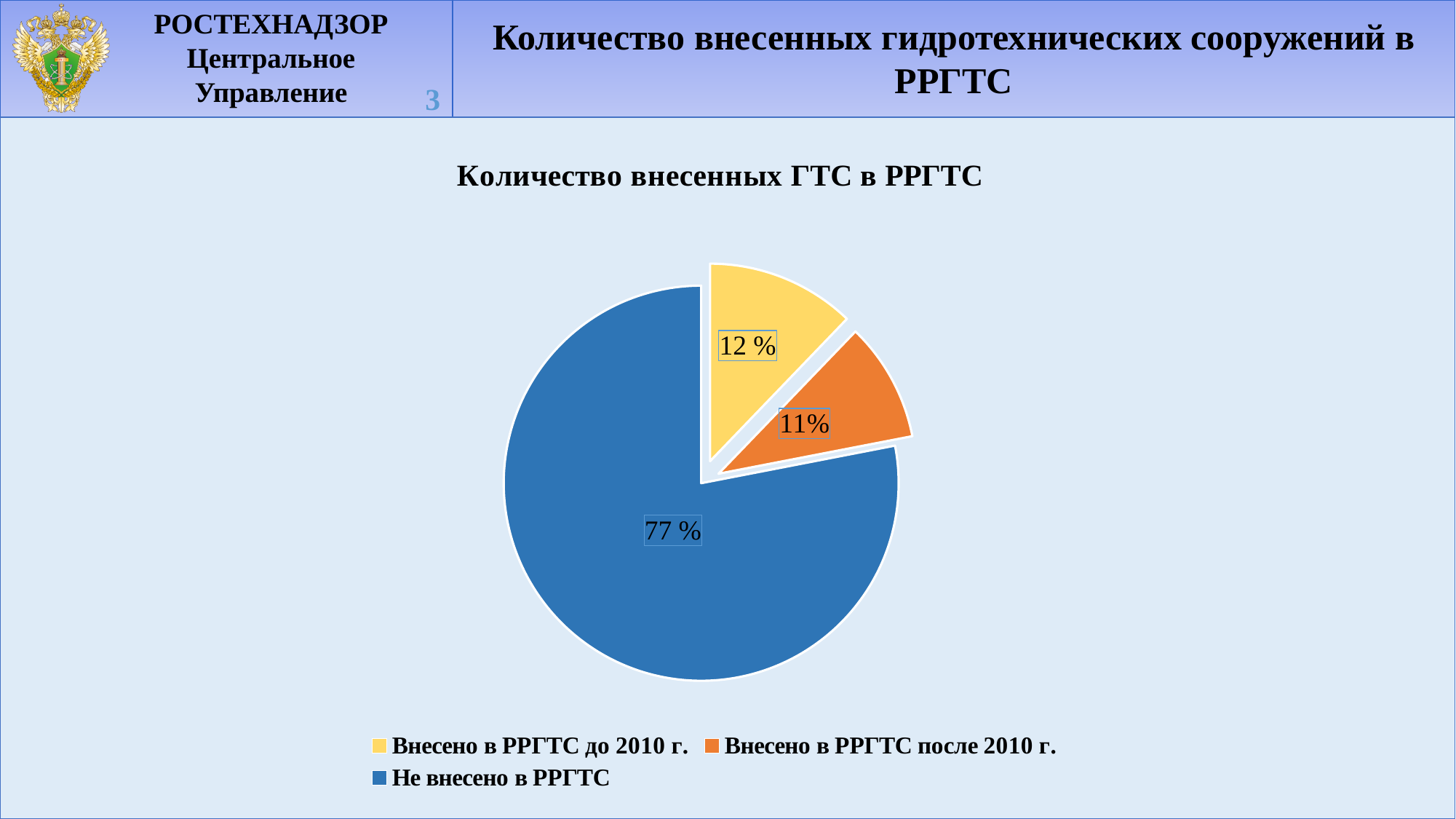
What share of the pie does "Не внесено в РРГТС" take? 77 % Which category has the smallest slice of the pie? Внесено в РРГТС после 2010 г. What is the value for "Внесено в РРГТС после 2010 г."? 11% What is the value for "Внесено в РРГТС до 2010 г."? 12 % What is the difference between the value for "Не внесено в РРГТС" and the value for "Внесено в РРГТС до 2010 г."? 65 % Which category has the largest slice of the pie? Не внесено в РРГТС How many entries does the legend list? 3 What is the value for "Не внесено в РРГТС"? 77 % How many slices does the pie chart have? 3 What kind of chart is shown on the slide? pie chart What is the title of the chart? Количество внесенных ГТС в РРГТС Which is larger: the value for "Не внесено в РРГТС" or the value for "Внесено в РРГТС после 2010 г."? Не внесено в РРГТС